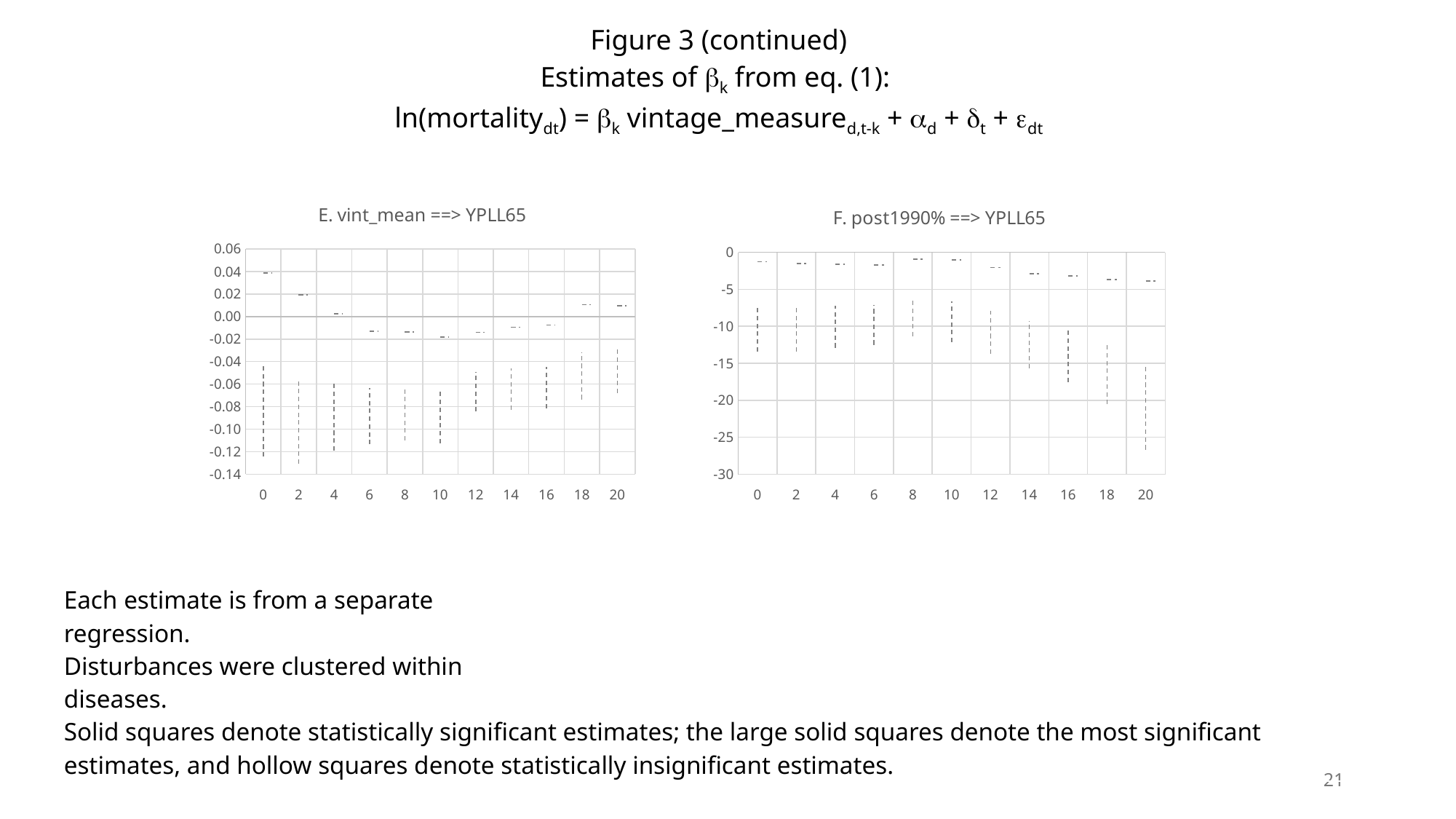
How many x-axis positions (lag values) are plotted in the chart titled "F. post1990% ==> YPLL65"? 11 In the chart titled "E. vint_mean ==> YPLL65", is the upper marker at x = 6 greater or less than -0.04? greater In the chart titled "F. post1990% ==> YPLL65", is the lowest point of the range at x = 0 greater or less than -15? greater In the chart titled "F. post1990% ==> YPLL65", is the upper marker at x = 0 greater or less than -5? greater How many x-axis positions (lag values) are plotted in the chart titled "E. vint_mean ==> YPLL65"? 11 What is the title of the left chart on the slide? E. vint_mean ==> YPLL65 In the chart titled "F. post1990% ==> YPLL65", do the upper markers rise or fall as x increases from 0 to 20? fall What is the lowest y-axis tick shown on the chart titled "F. post1990% ==> YPLL65"? -30